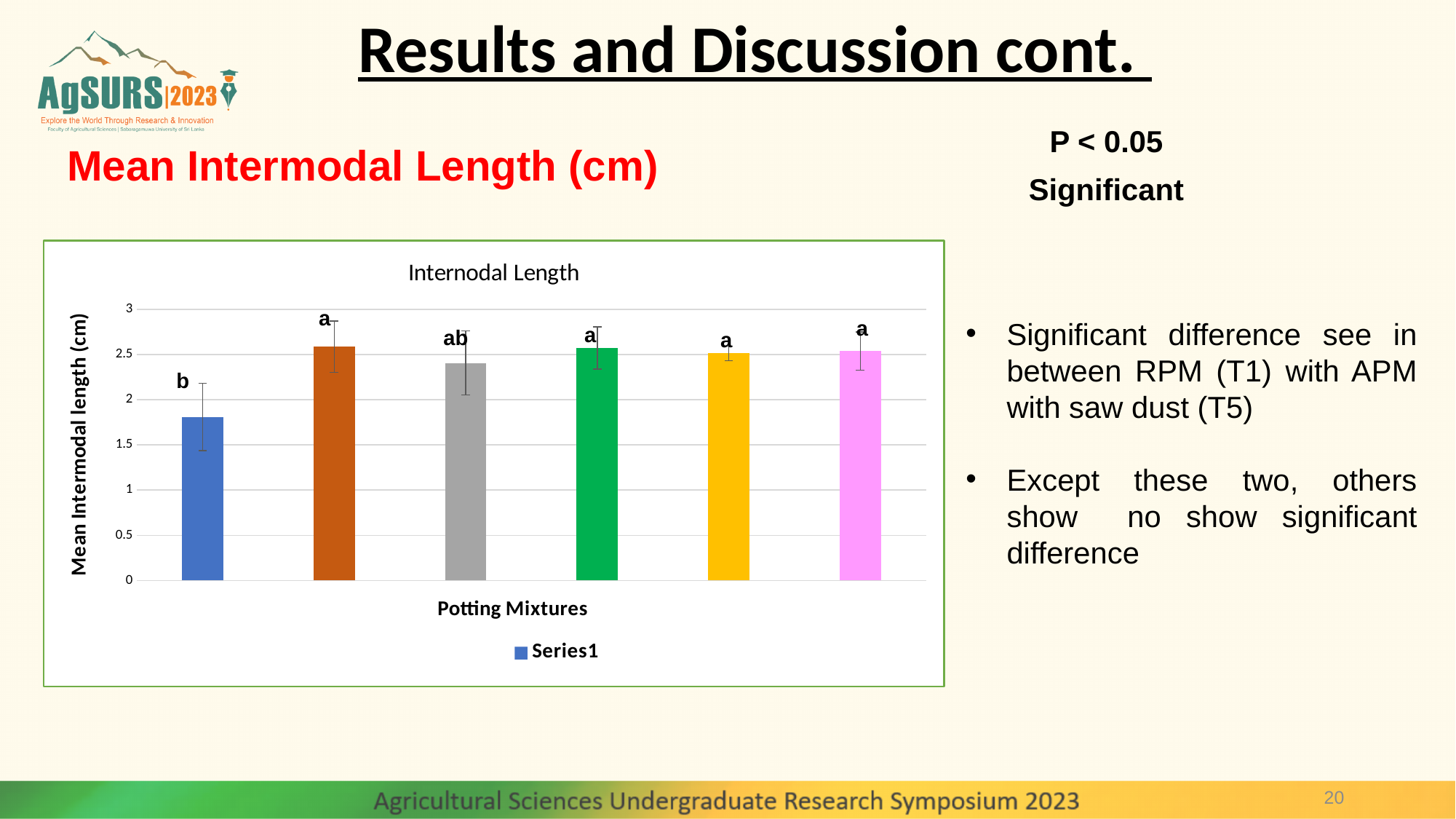
Which is larger, the third (grey) bar or the fourth (green) bar? the fourth (green) bar Is the value of the first (blue) bar greater or less than 2? less Is the value of the third (grey) bar greater or less than 2.5? less Which bar is the lowest in the chart? the first (blue) bar Is the value of the first (blue) bar greater or less than 1.5? greater Which is larger, the first (blue) bar or the second (orange) bar? the second (orange) bar How many bars are plotted in the Internodal Length chart? 6 How many series does the legend of the chart list? 1 What is the label of the vertical axis of the chart? Mean Intermodal length (cm) What kind of chart is shown on the slide? bar chart What is the title printed inside the chart area? Internodal Length